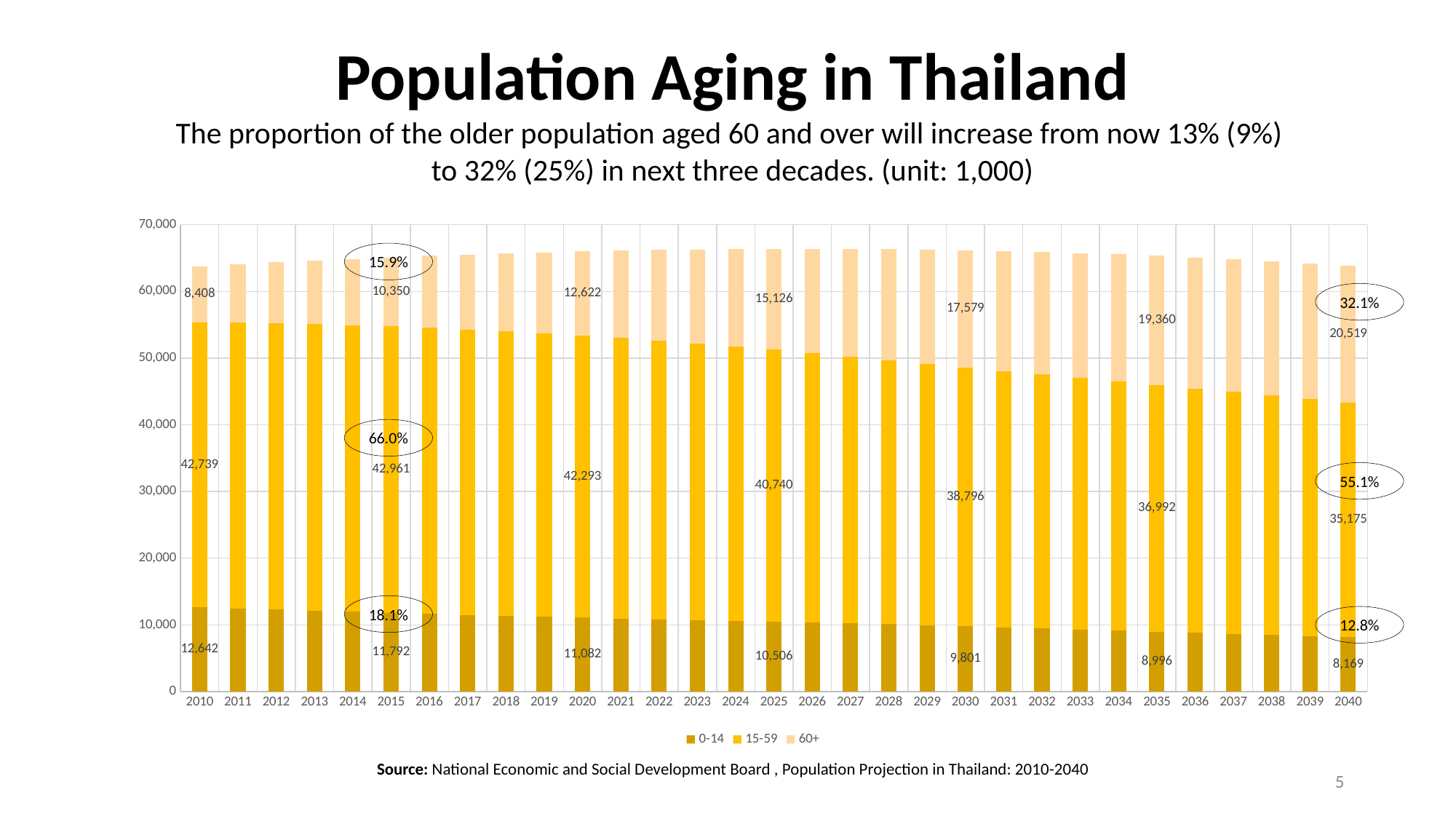
Is the 15-59 value for 2040 greater or less than 40,000? less What is the value of the 60+ series for 2035? 19,360 What is the value of the 60+ series for 2010? 8,408 Which is larger, the 0-14 value for 2010 or the 0-14 value for 2040? 2010 What is the total of the stacked bar for 2010? 63,789 What is the value of the 15-59 series for 2025? 40,740 What type of chart is shown on the slide? stacked bar chart What is the value of the 0-14 series for 2040? 8,169 How many series does the legend list? 3 What percentage is shown in the circled annotation for the 60+ segment in 2040? 32.1% Does the 60+ series rise or fall from 2010 to 2040? rise What is the difference between the 60+ value for 2040 and the 60+ value for 2010? 12,111